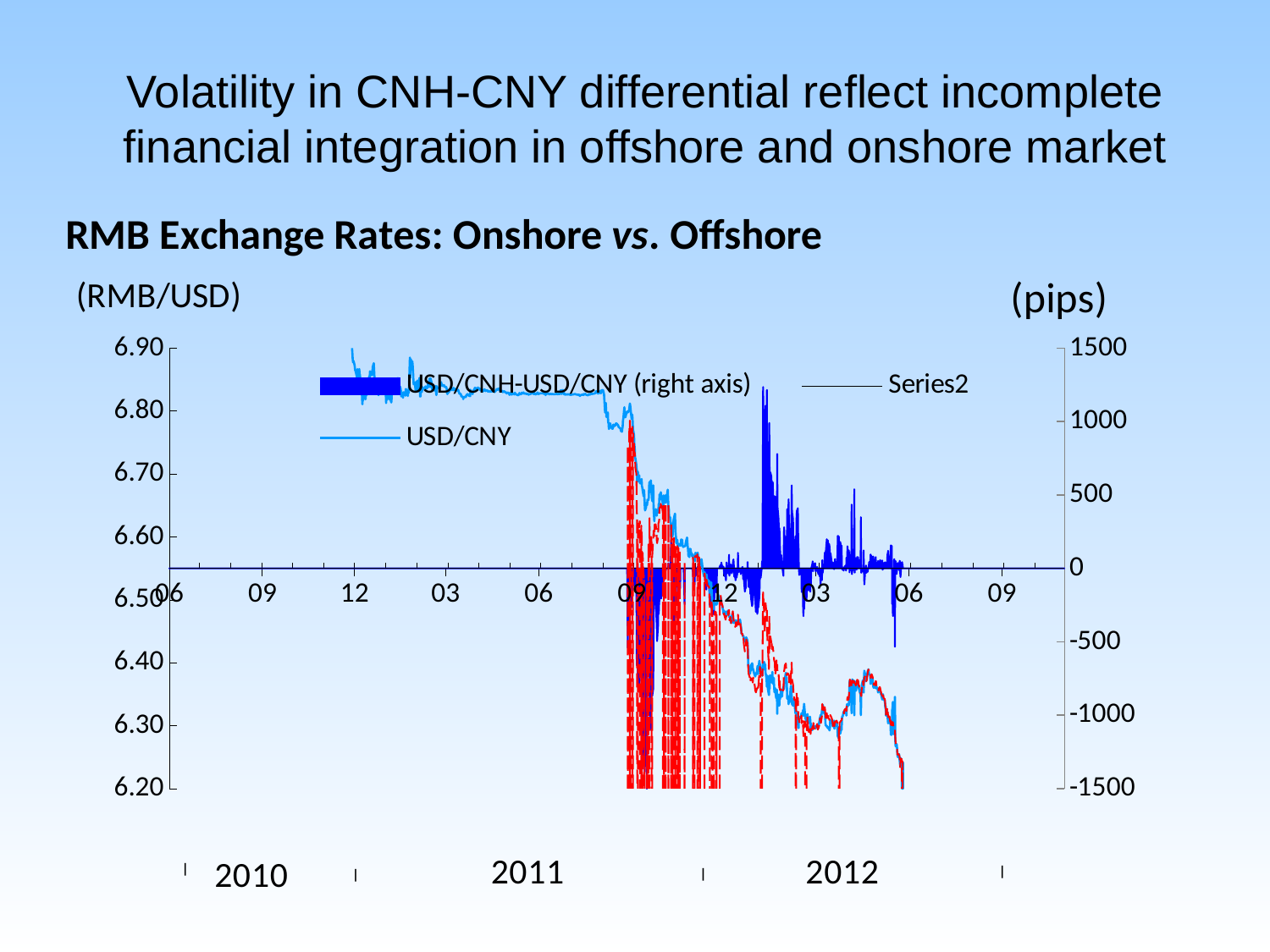
Does the USD/CNY line rise or fall overall from 2010 to 2012? Fall Which series is plotted against the right axis according to the legend? USD/CNH-USD/CNY What is the lowest value shown on the right-hand (pips) axis? -1500 In which year does the largest positive spike in the USD/CNH-USD/CNY differential occur? 2012 What kind of chart is shown on the slide? A line chart with bars (combination chart) What unit is shown for the right-hand axis of the chart? pips Is the USD/CNY value around June 2012 greater or less than 6.50? less How many series does the legend list? 3 What is the title of the chart? RMB Exchange Rates: Onshore vs. Offshore Is the largest spike of the USD/CNH-USD/CNY differential (right axis) greater or less than 1000 pips? greater What is the highest value shown on the left-hand (RMB/USD) axis? 6.90